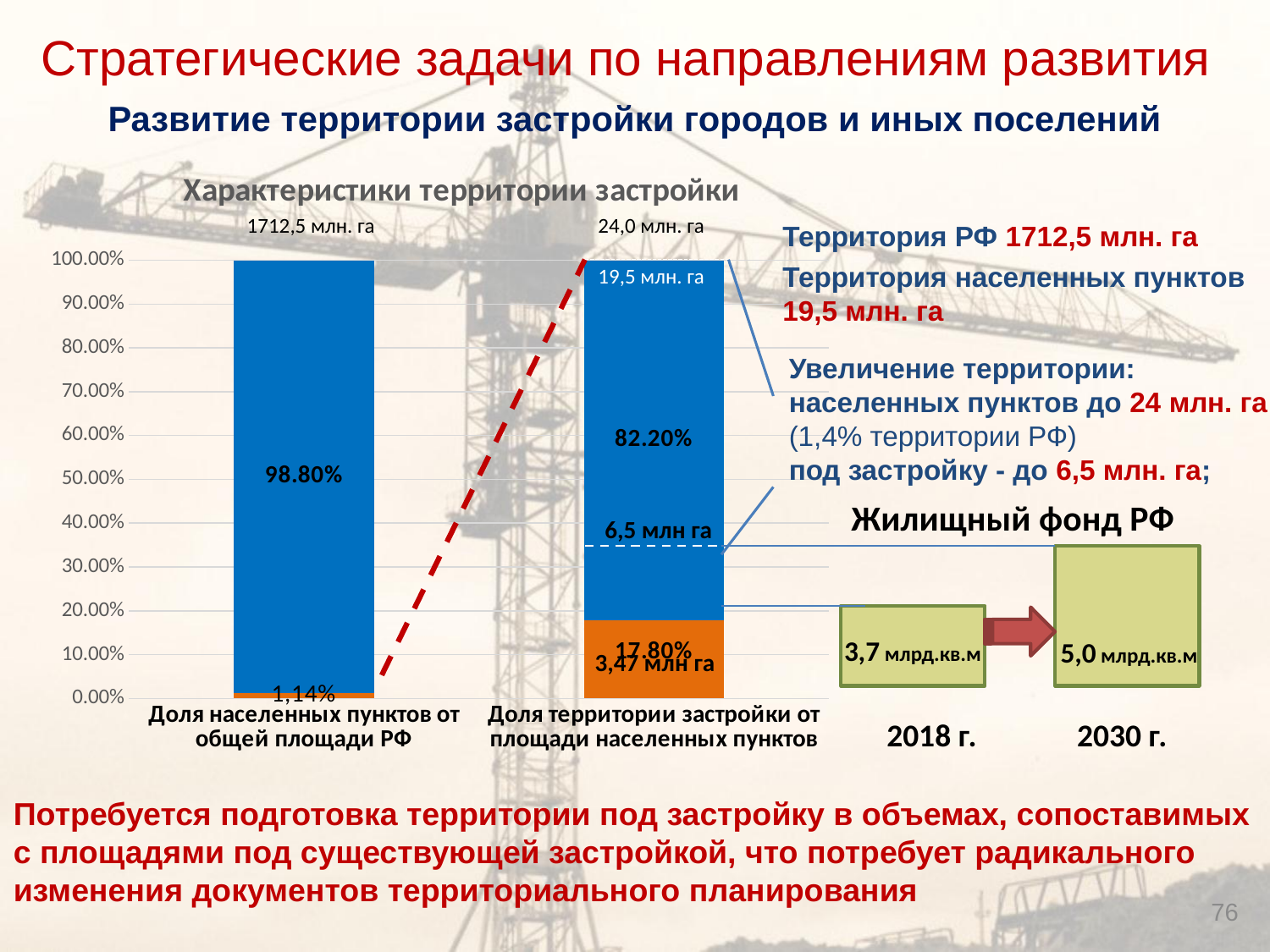
How many categories are shown on the x axis of the chart? 2 What label is printed above the bar for "Доля населенных пунктов от общей площади РФ"? 1712,5 млн. га What kind of chart is shown under the title "Характеристики территории застройки"? bar chart What is the value of the blue segment for "Доля территории застройки от площади населенных пунктов"? 82.20% What is the value of the orange segment for "Доля населенных пунктов от общей площади РФ"? 1,14% What is the title of the chart? Характеристики территории застройки What is the value of the blue segment for "Доля населенных пунктов от общей площади РФ"? 98.80% What is the difference between the blue segment values of the two categories (98.80% and 82.20%)? 16.60% Which category has the highest blue segment value? Доля населенных пунктов от общей площади РФ Which category has the larger orange segment? Доля территории застройки от площади населенных пунктов Is the orange segment for "Доля территории застройки от площади населенных пунктов" greater or less than 20%? less What is the value of the orange segment for "Доля территории застройки от площади населенных пунктов"? 17.80%